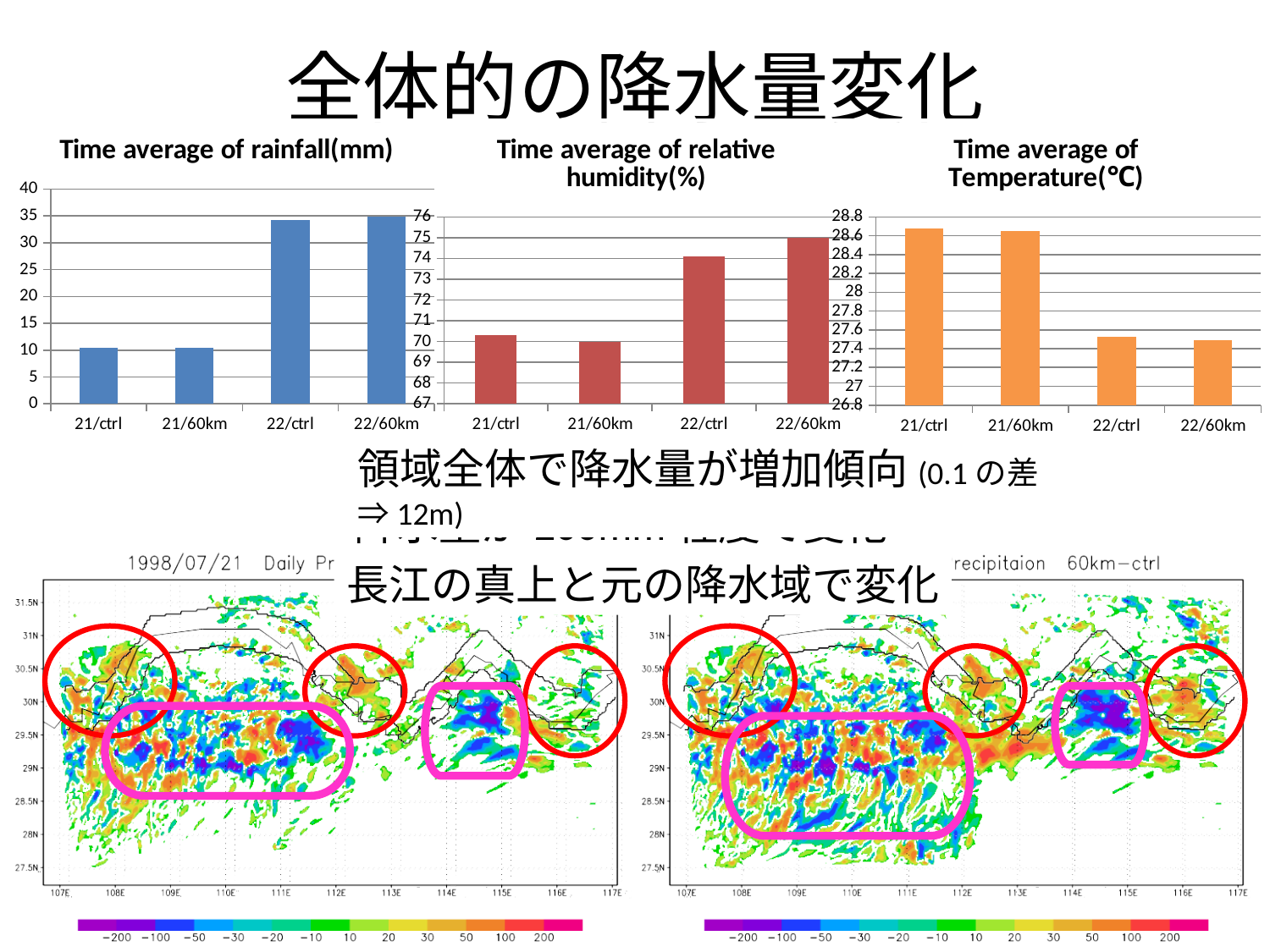
How many categories are shown on the x axis of the 'Time average of rainfall(mm)' chart? 4 In the 'Time average of rainfall(mm)' chart, which is larger, 21/60km or 22/60km? 22/60km What colour are the bars in the 'Time average of Temperature(℃)' chart? orange In the 'Time average of rainfall(mm)' chart, is the value for 21/ctrl greater or less than 15? less In the 'Time average of Temperature(℃)' chart, do the values rise or fall from the 21 categories to the 22 categories? fall In the 'Time average of relative humidity(%)' chart, is the value for 21/60km greater or less than 71? less In the 'Time average of Temperature(℃)' chart, is the value for 22/ctrl greater or less than 28? less In the 'Time average of relative humidity(%)' chart, which category has the highest value? 22/60km In the 'Time average of Temperature(℃)' chart, which is larger, 21/ctrl or 22/ctrl? 21/ctrl What kind of chart is the 'Time average of rainfall(mm)' chart? bar chart